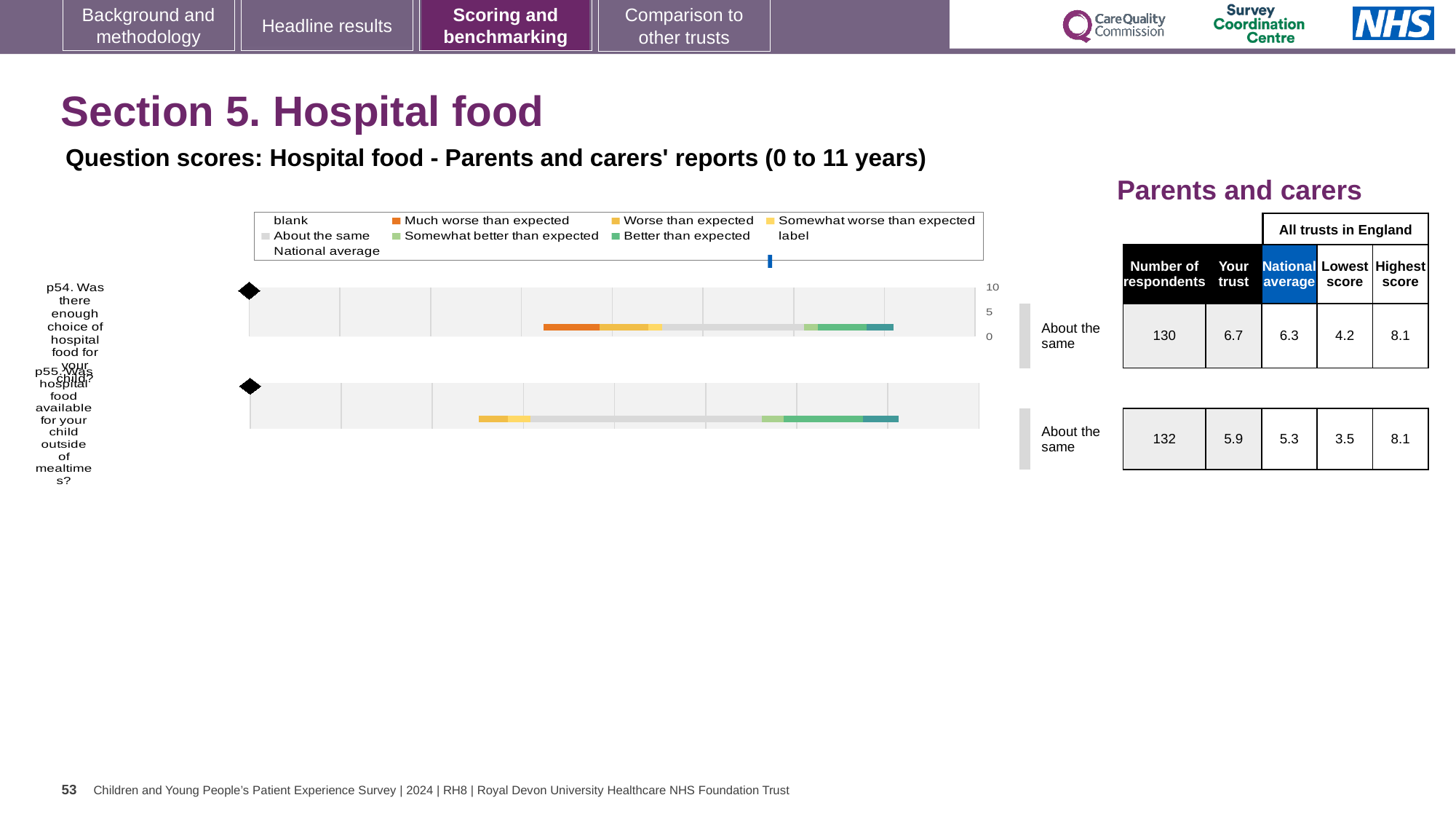
What kind of chart is used to show the question scores for hospital food? bar chart Which question has the higher 'Your trust' score, p54 or p55? p54 What benchmark category is shown for both p54 and p55? About the same What is the lowest score across all trusts in England for p55? 3.5 What is the highest score across all trusts in England for p54? 8.1 What is the national average for p55? 5.3 How many respondents answered p55? 132 What is the national average for p54? 6.3 What is the 'Your trust' score for p55 (hospital food available outside of mealtimes)? 5.9 What is the difference between the 'Your trust' score and the national average for p54? 0.4 How many questions (rows) are plotted in the hospital food chart? 2 What is the 'Your trust' score for p54 (enough choice of hospital food for your child)? 6.7